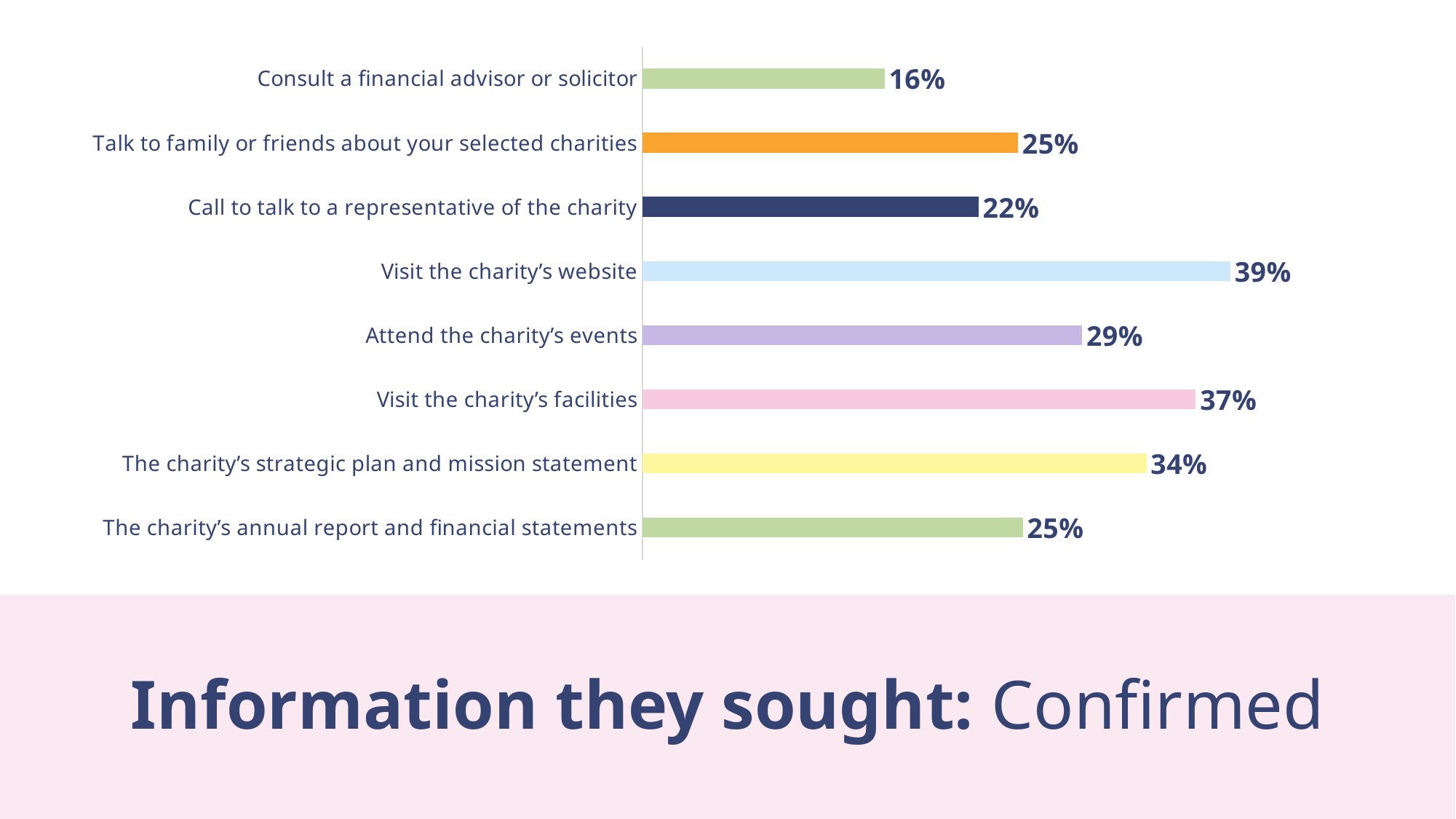
Which is larger: 'Call to talk to a representative of the charity' or 'Talk to family or friends about your selected charities'? Talk to family or friends about your selected charities Which category has the highest value? Visit the charity's website What kind of chart is shown on the slide? Bar chart What is the value for 'The charity's strategic plan and mission statement'? 34% What percentage of respondents said they visit the charity's website? 39% What is the value for 'Consult a financial advisor or solicitor'? 16% Which category has the lowest value? Consult a financial advisor or solicitor What percentage is shown for 'Attend the charity's events'? 29% What is the difference between 'Attend the charity's events' and 'Consult a financial advisor or solicitor'? 13% What is the difference between 'Visit the charity's website' and 'Visit the charity's facilities'? 2% How many categories are shown in the chart? 8 What is the title text shown at the bottom of the slide? Information they sought: Confirmed